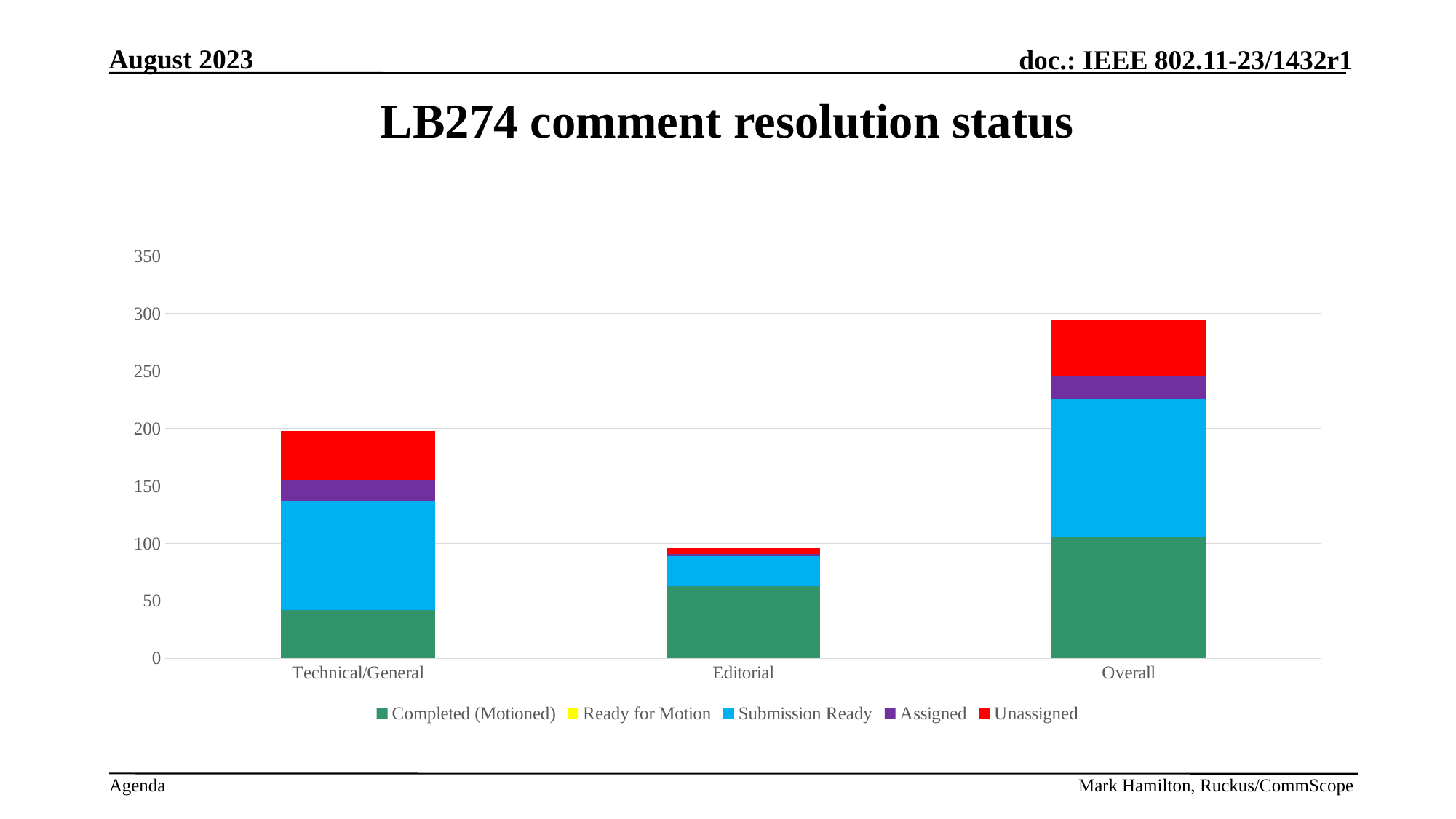
Is the total of the Editorial bar greater or less than 100? less Which has the larger Completed (Motioned) segment, Technical/General or Editorial? Editorial How many categories are shown on the x axis? 3 What is the title of the chart? LB274 comment resolution status Which category has the shortest stacked bar? Editorial Which category has the tallest stacked bar? Overall Which colour represents the Unassigned series in the legend? red Is the total of the Overall bar greater or less than 250? greater What kind of chart is shown on the slide? stacked bar chart Is the total of the Technical/General bar greater or less than 150? greater How many series does the legend list? 5